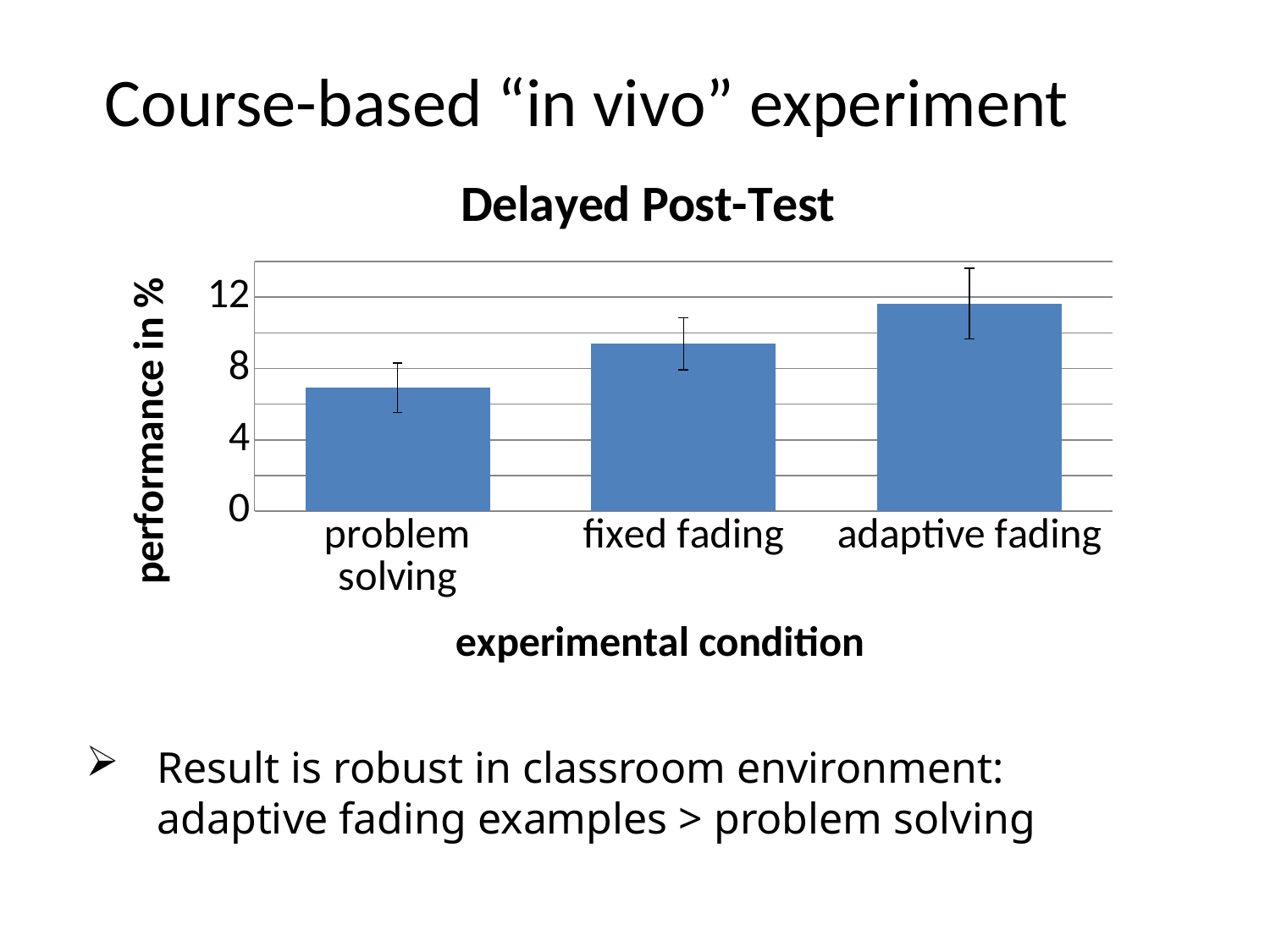
Is the value for adaptive fading greater or less than 8? greater Which experimental condition has the lowest performance? problem solving Which has the higher performance, fixed fading or problem solving? fixed fading Which experimental condition has the highest performance? adaptive fading What kind of chart is shown on the slide? bar chart How many experimental conditions are plotted in the chart? 3 Is the value for problem solving greater or less than 8? less Do the bar values rise or fall from left to right across the experimental conditions? rise Is the value for fixed fading greater or less than 8? greater What is the label of the vertical axis? performance in % Which has the higher performance, adaptive fading or fixed fading? adaptive fading What is the title of the chart? Delayed Post-Test